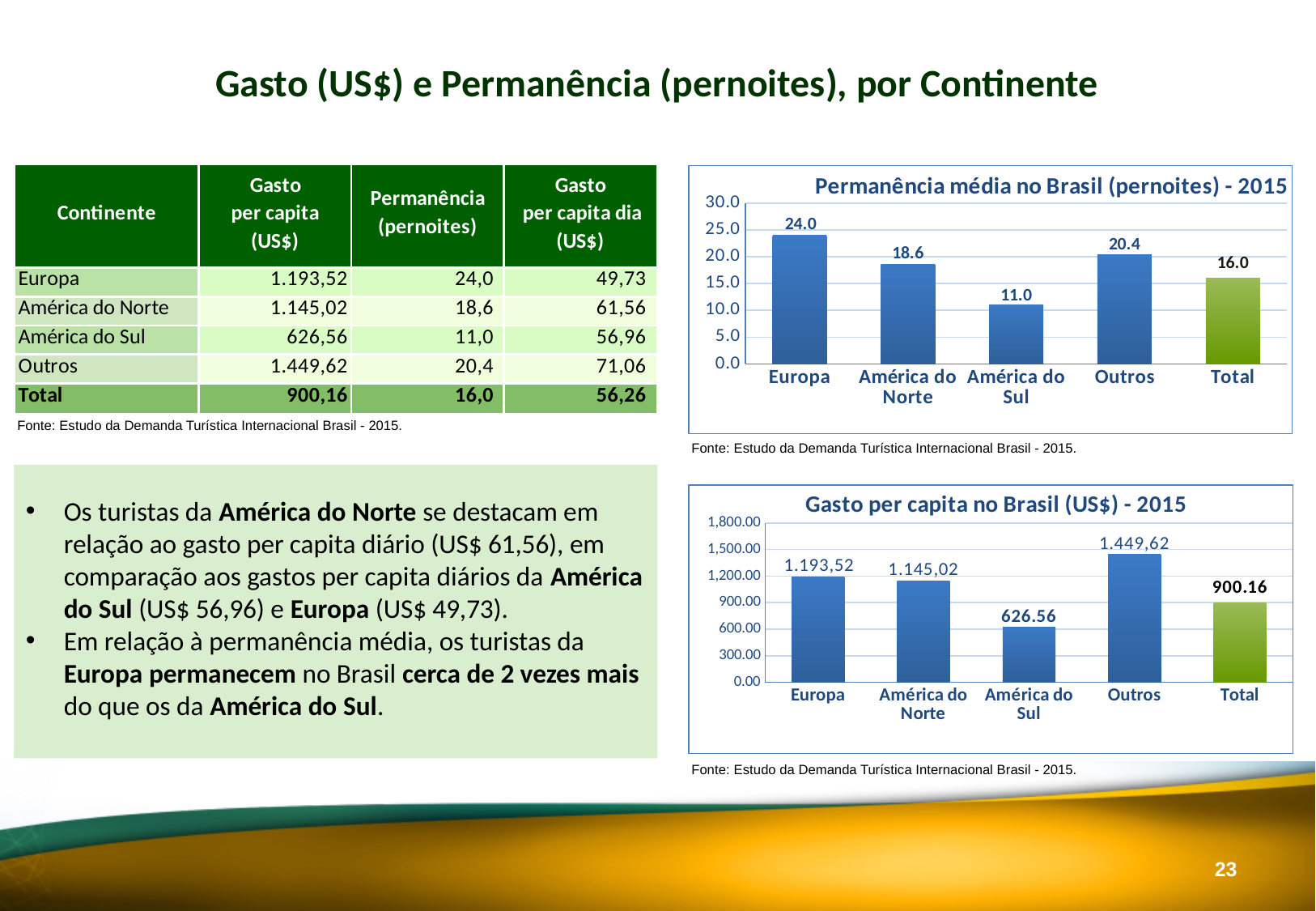
In the chart 'Permanência média no Brasil (pernoites) - 2015', which category has the highest value? Europa In the chart 'Permanência média no Brasil (pernoites) - 2015', what is the difference between the values for Europa and América do Sul? 13.0 In the chart 'Permanência média no Brasil (pernoites) - 2015', how many bars are plotted? 5 What kind of chart is 'Gasto per capita no Brasil (US$) - 2015'? bar chart In the chart 'Gasto per capita no Brasil (US$) - 2015', is the value for América do Sul greater or less than 900.00? less In the chart 'Gasto per capita no Brasil (US$) - 2015', what is the value for Total? 900.16 In the chart 'Permanência média no Brasil (pernoites) - 2015', what is the value for Europa? 24.0 In the chart 'Gasto per capita no Brasil (US$) - 2015', which is larger, the value for Europa or the value for Outros? Outros In the chart 'Permanência média no Brasil (pernoites) - 2015', which category has the lowest value? América do Sul In the chart 'Permanência média no Brasil (pernoites) - 2015', what is the value for América do Sul? 11.0 In the chart 'Gasto per capita no Brasil (US$) - 2015', which category has the lowest value? América do Sul In the chart 'Gasto per capita no Brasil (US$) - 2015', what is the value for Outros? 1.449,62